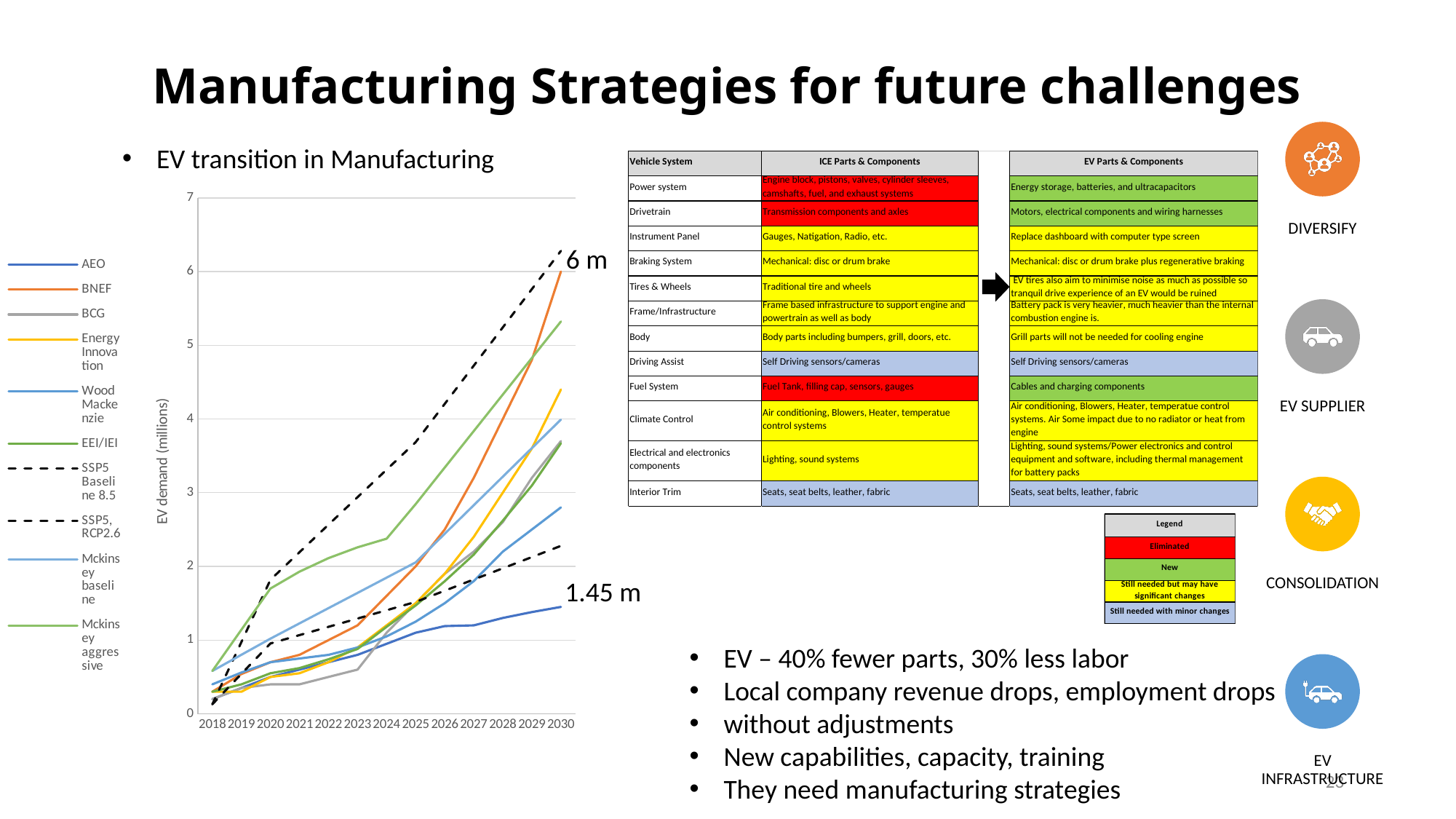
How many years are shown along the x axis of the chart? 13 How many series does the chart's legend list? 10 Does the AEO series rise or fall from 2018 to 2030? Rise In 2030, which is larger: the value for BNEF or the value for AEO? BNEF Is the value for Mckinsey aggressive in 2024 greater or less than 2? greater Is the value for BNEF in 2030 greater or less than 5? greater Is the value for AEO in 2030 greater or less than 2? less What kind of chart is shown on the slide? Line chart What is the label of the chart's y axis? EV demand (millions) What is the first year shown on the x axis of the chart? 2018 Which series has the lowest value in 2030? AEO